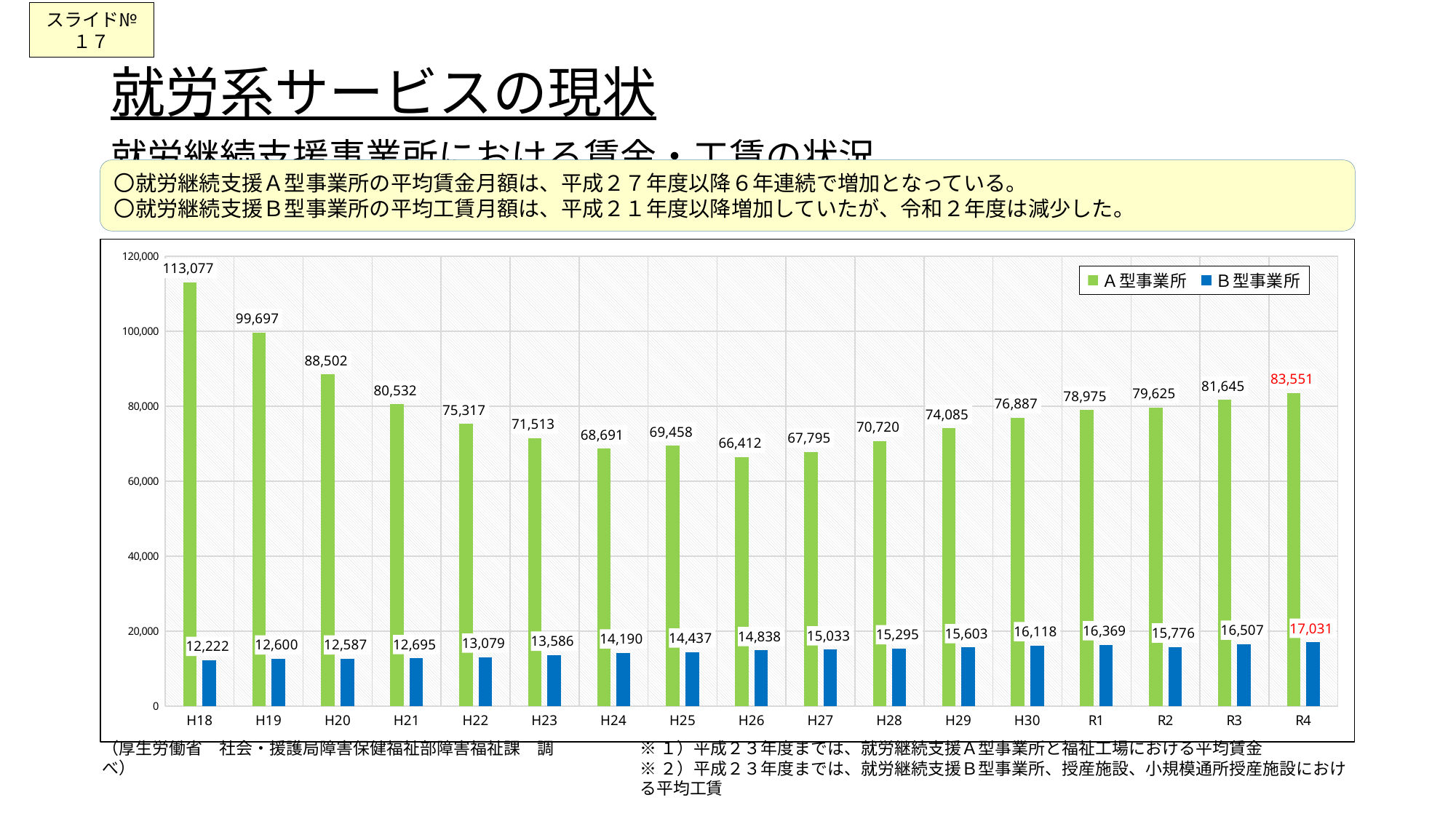
How many series does the legend list? 2 How many years are shown on the x axis? 17 Which year has the lowest value for A型事業所? H26 Do the A型事業所 values rise or fall from H18 to H26? fall Is the value for A型事業所 in H22 greater or less than 80,000? less What is the value for A型事業所 in H18? 113,077 What is the value for A型事業所 in H26? 66,412 Which year has the highest value for A型事業所? H18 What is the value for B型事業所 in R4? 17,031 What is the difference between the A型事業所 values for R4 and R3? 1,906 Which year has the lowest value for B型事業所? H18 Which is larger, the B型事業所 value for R1 or for R2? R1